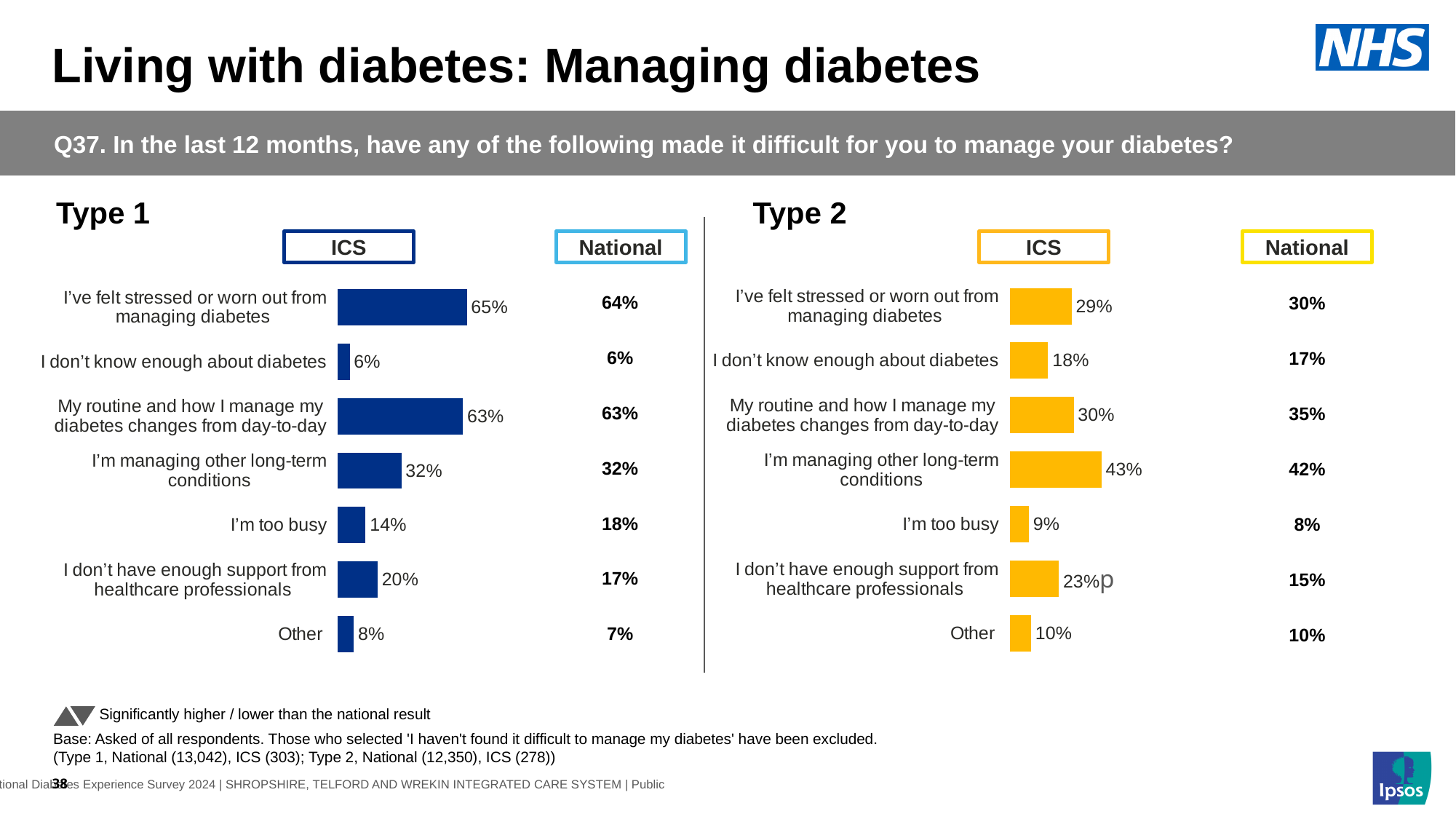
In the Type 2 chart, what is the difference between the ICS and National values for 'I don't have enough support from healthcare professionals'? 8 percentage points What colour are the ICS bars in the Type 2 chart? Yellow In the Type 2 chart, which category has the lowest ICS value? I'm too busy In the Type 1 chart, which category has the lowest ICS value? I don't know enough about diabetes In the Type 2 chart, what is the ICS value for 'I'm managing other long-term conditions'? 43% In the Type 1 chart, what is the ICS value for 'I've felt stressed or worn out from managing diabetes'? 65% In the Type 1 chart, which category has the highest ICS value? I've felt stressed or worn out from managing diabetes How many categories are shown in the Type 2 chart? 7 In the Type 1 chart, what is the difference between the ICS values for 'I'm managing other long-term conditions' and 'I'm too busy'? 18 percentage points In the Type 1 chart, which is larger: the ICS value for 'I'm too busy' or the ICS value for 'I don't have enough support from healthcare professionals'? I don't have enough support from healthcare professionals In the Type 2 chart, what is the National value for 'My routine and how I manage my diabetes changes from day-to-day'? 35% What kind of chart is used for the Type 1 ICS results? Bar chart